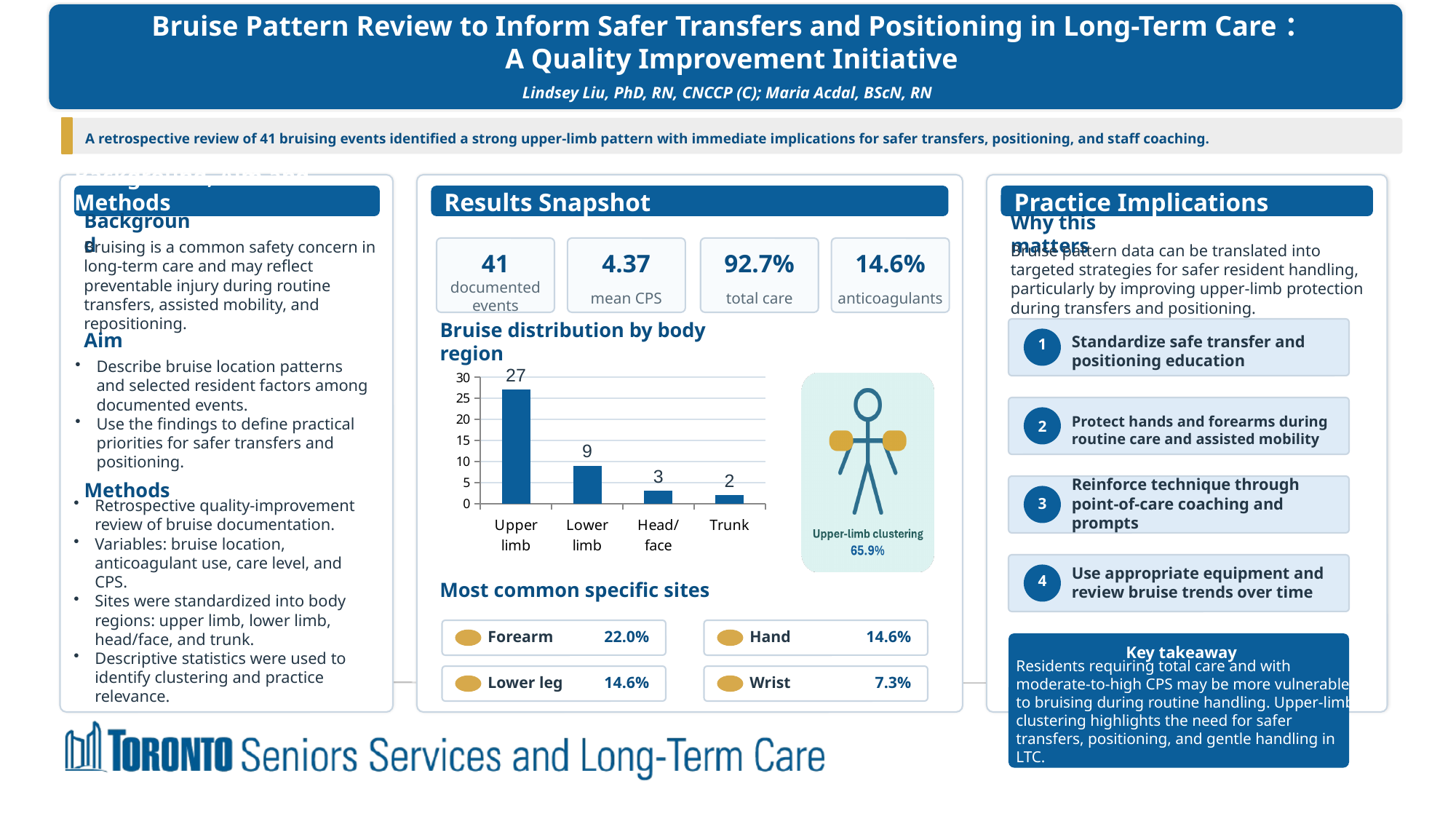
What is the value for Trunk in the bruise distribution by body region chart? 2 Which body region has the lowest number of bruises in the chart? Trunk What kind of chart is used to show bruise distribution by body region? Bar chart Which body region has the highest number of bruises in the chart? Upper limb What is the value for Head/face in the bruise distribution by body region chart? 3 How many body region categories are shown in the bruise distribution chart? 4 Which is larger in the bruise distribution chart, Head/face or Trunk? Head/face What is the value for Lower limb in the bruise distribution by body region chart? 9 What is the value for Upper limb in the bruise distribution by body region chart? 27 What is the difference between the Upper limb and Lower limb values in the bruise distribution chart? 18 Is the value for Lower limb in the bruise distribution chart greater or less than 10? less Do the values in the bruise distribution chart rise or fall from left to right across the body regions? Fall